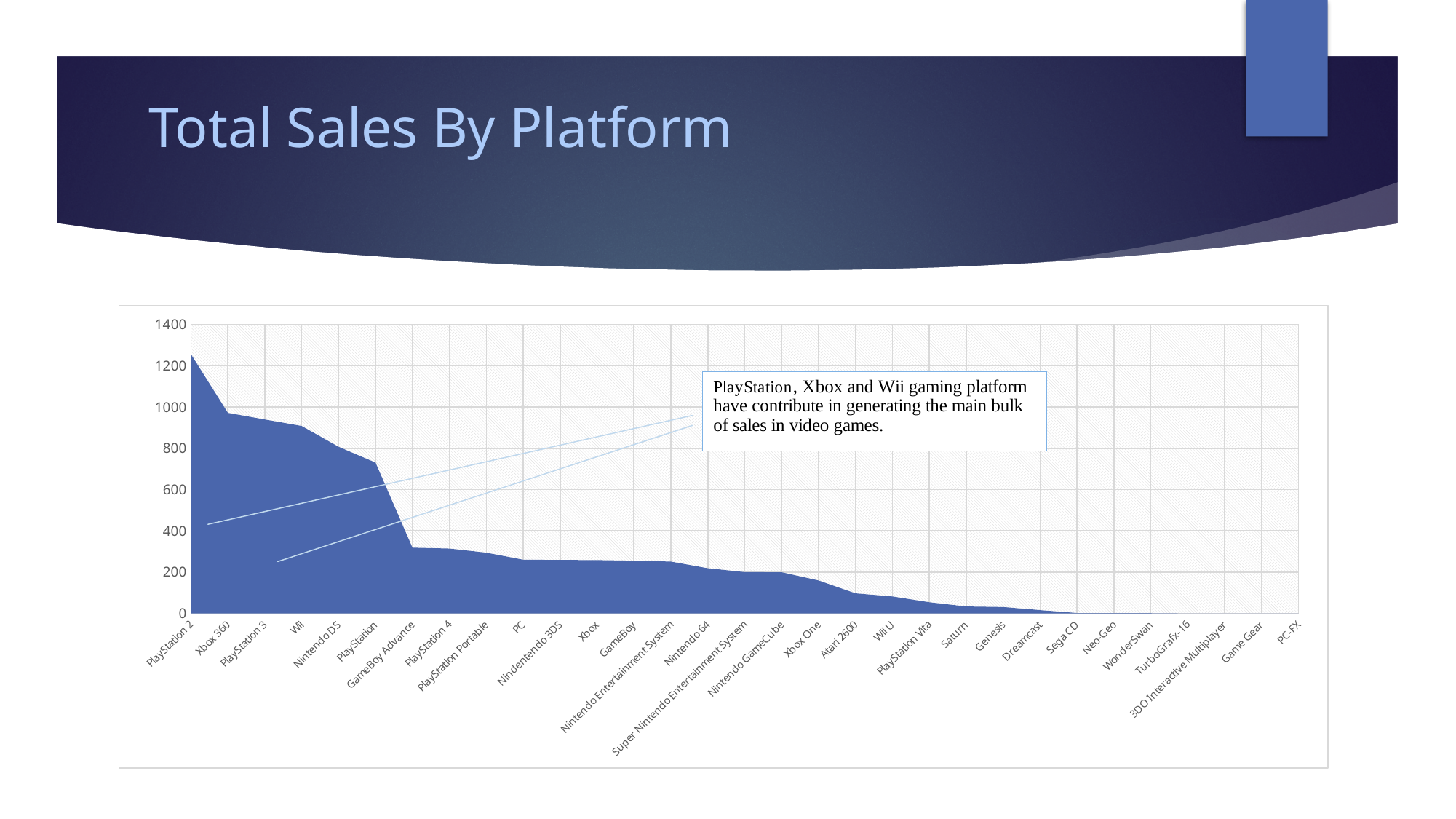
Is the value for PlayStation 2 greater or less than 1200? greater Is the value for Xbox 360 greater or less than 1000? less How many platforms are shown on the x axis? 31 Which platform has the highest total sales? PlayStation 2 Which has higher total sales, PlayStation 3 or PC? PlayStation 3 Is the value for PlayStation greater or less than 600? greater Do the values rise or fall moving from left to right along the x axis? fall What is the title of the slide? Total Sales By Platform What kind of chart is shown on the slide? area chart Which platform is listed last on the x axis? PC-FX